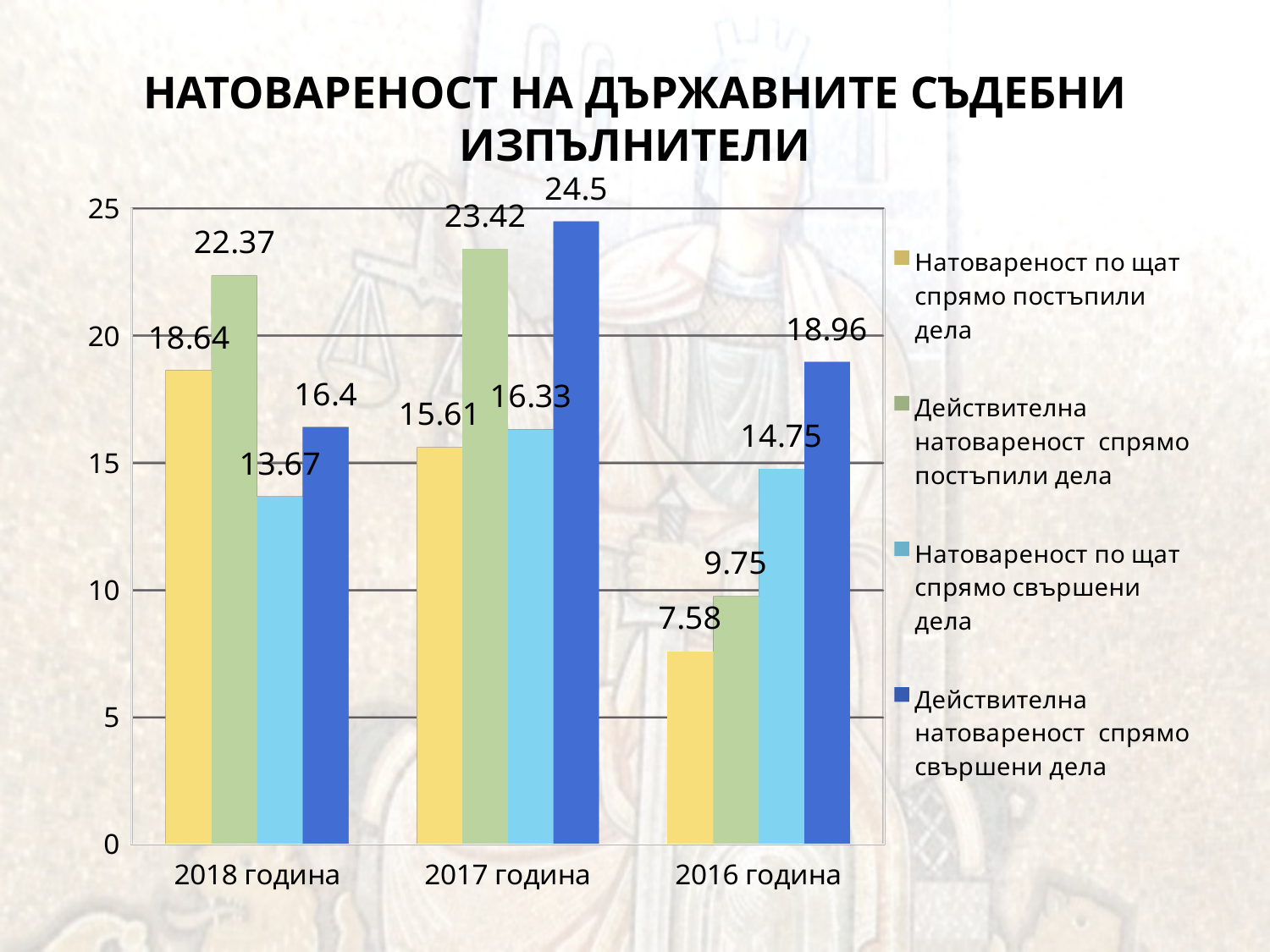
What is the value of "Натовареност по щат спрямо свършени дела" for 2016 година? 14.75 What is the value of "Натовареност по щат спрямо постъпили дела" for 2018 година? 18.64 What is the value of "Действителна натовареност спрямо свършени дела" for 2017 година? 24.5 Which is larger for 2016 година: "Действителна натовареност спрямо свършени дела" or "Натовареност по щат спрямо свършени дела"? Действителна натовареност спрямо свършени дела How many year categories are shown on the x axis? 3 What is the difference between "Действителна натовареност спрямо постъпили дела" and "Натовареност по щат спрямо постъпили дела" for 2017 година? 7.81 What is the title of the chart? НАТОВАРЕНОСТ НА ДЪРЖАВНИТЕ СЪДЕБНИ ИЗПЪЛНИТЕЛИ What is the value of "Действителна натовареност спрямо постъпили дела" for 2018 година? 22.37 What kind of chart is shown on the slide? bar chart Which year has the highest value for "Действителна натовареност спрямо постъпили дела"? 2017 година How many series does the legend list? 4 Which year has the lowest value for "Натовареност по щат спрямо постъпили дела"? 2016 година